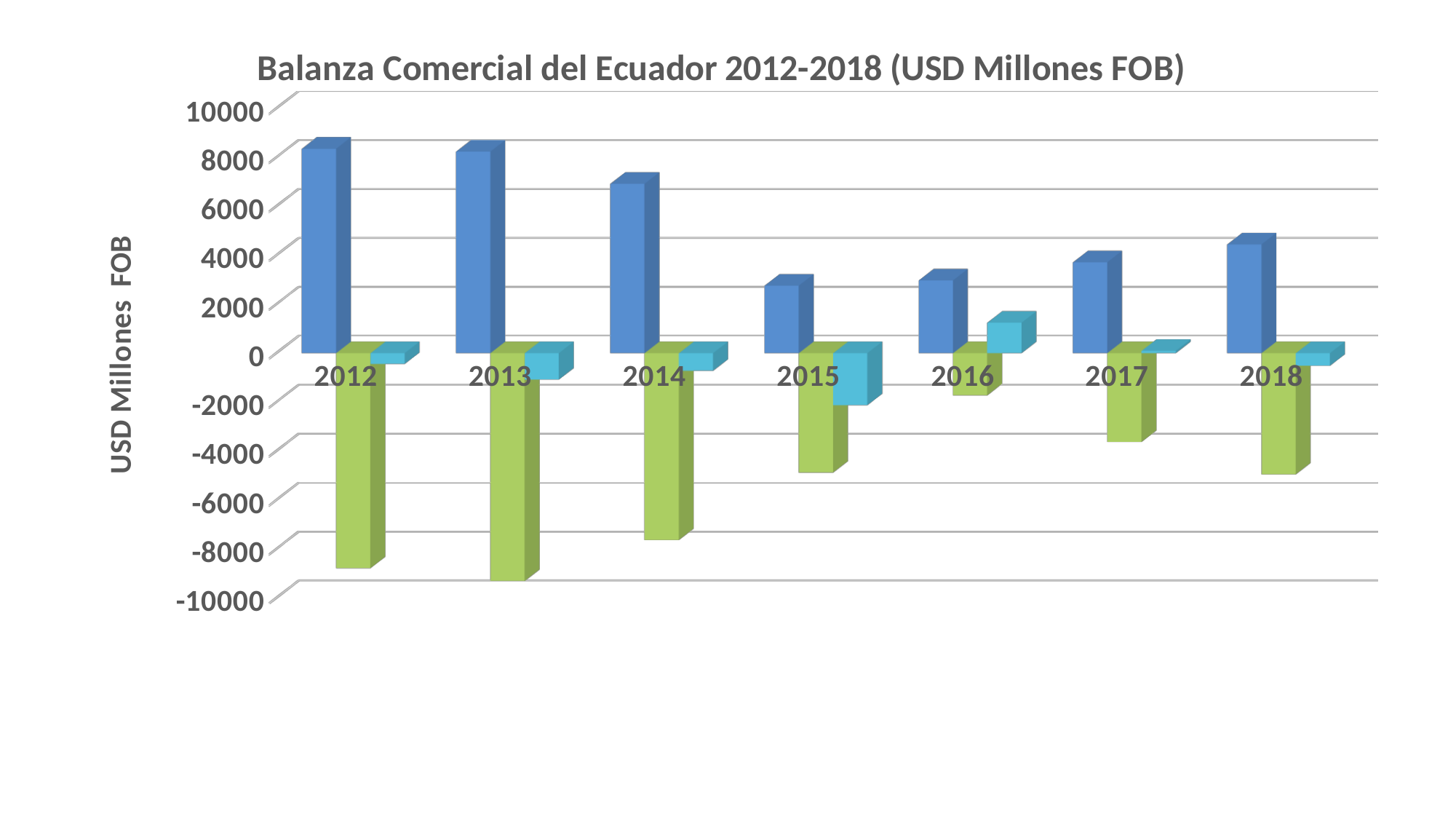
What kind of chart is shown on the slide? bar chart Which year has a larger blue bar, 2014 or 2017? 2014 Is the value of the green bar for 2015 greater or less than -4000? less What is the title of the chart? Balanza Comercial del Ecuador 2012-2018 (USD Millones FOB) In which year is the green bar the highest (least negative)? 2016 What is the label of the vertical axis? USD Millones FOB In which year is the green bar the lowest (most negative)? 2013 Is the value of the blue bar for 2014 greater or less than 6000? greater Is the value of the green bar for 2013 greater or less than -8000? less How many years are shown on the x axis of the chart? 7